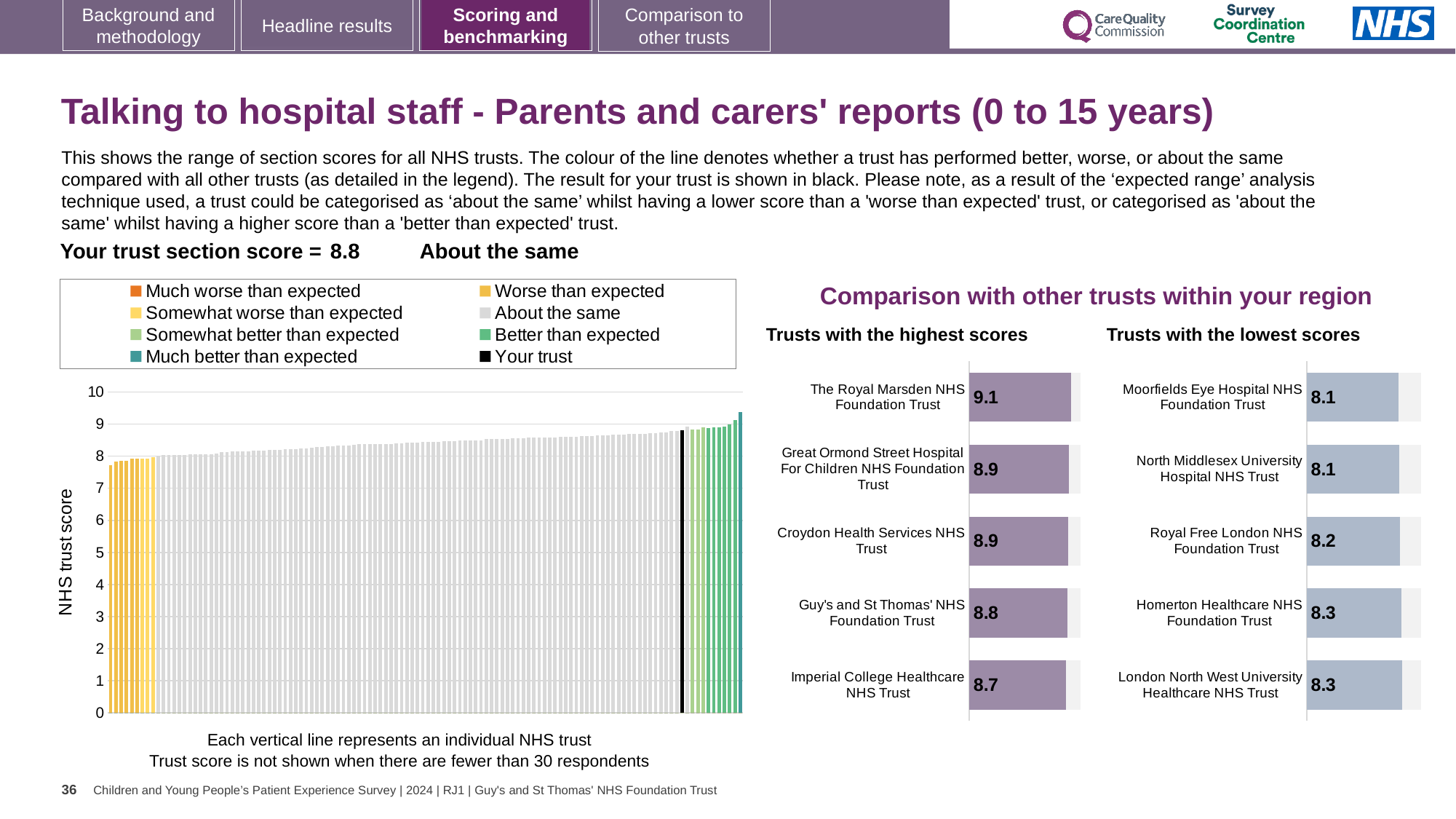
In the 'Trusts with the lowest scores' chart, what is the score for Moorfields Eye Hospital NHS Foundation Trust? 8.1 In the 'Trusts with the highest scores' chart, which has the larger score: The Royal Marsden NHS Foundation Trust or Guy's and St Thomas' NHS Foundation Trust? The Royal Marsden NHS Foundation Trust In the 'Trusts with the highest scores' chart, what is the score for The Royal Marsden NHS Foundation Trust? 9.1 In the 'Trusts with the lowest scores' chart, what is the difference between the scores of Homerton Healthcare NHS Foundation Trust and Moorfields Eye Hospital NHS Foundation Trust? 0.2 In the 'Trusts with the highest scores' chart, what is the difference between the scores of The Royal Marsden NHS Foundation Trust and Imperial College Healthcare NHS Trust? 0.4 How many entries does the legend of the left-hand chart list? 8 In the 'Trusts with the highest scores' chart, what is the score for Imperial College Healthcare NHS Trust? 8.7 In the left-hand chart, is the value for the black 'Your trust' bar greater or less than 8? greater In the 'Trusts with the highest scores' chart, which trust has the highest score? The Royal Marsden NHS Foundation Trust What kind of chart is the large chart on the left showing all NHS trusts? Bar chart In the 'Trusts with the lowest scores' chart, what is the score for Royal Free London NHS Foundation Trust? 8.2 How many trusts are shown in the 'Trusts with the lowest scores' chart? 5